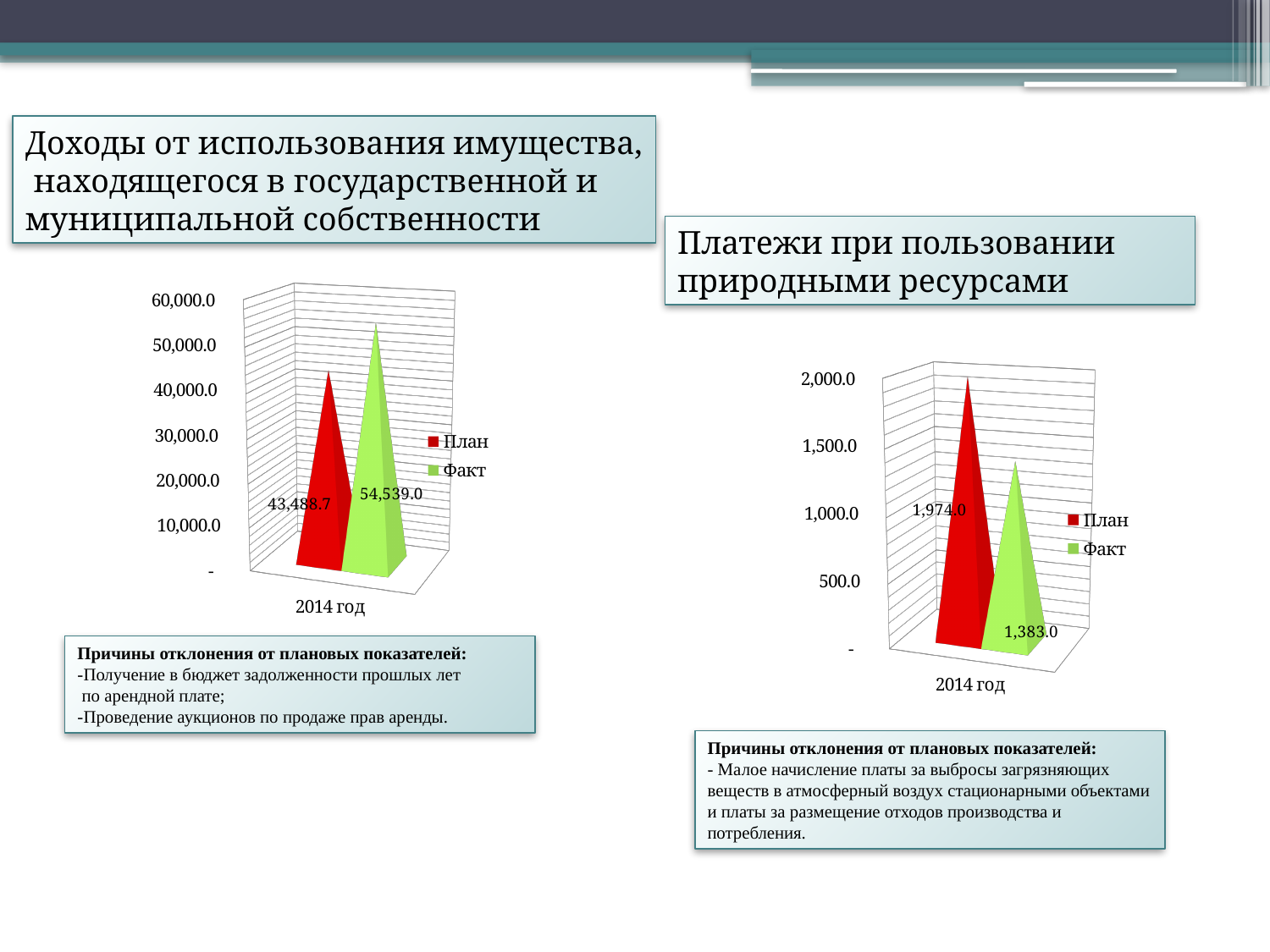
What kind of chart is the right chart (Платежи при пользовании природными ресурсами)? bar chart On the right chart (Платежи при пользовании природными ресурсами), is the value for Факт greater or less than 1,500.0? less On the left chart (Доходы от использования имущества), what is the value for Факт in 2014 год? 54,539.0 On the left chart (Доходы от использования имущества), what is the value for План in 2014 год? 43,488.7 How many series does the legend of the left chart (Доходы от использования имущества) list? 2 On the left chart (Доходы от использования имущества), is the value for План greater or less than 40,000.0? greater On the right chart (Платежи при пользовании природными ресурсами), which series is lower, План or Факт? Факт On the right chart (Платежи при пользовании природными ресурсами), what is the value for Факт? 1,383.0 On the right chart (Платежи при пользовании природными ресурсами), what is the value for План? 1,974.0 On the left chart (Доходы от использования имущества), which series is higher, План or Факт? Факт On the left chart (Доходы от использования имущества), what is the difference between Факт and План? 11,050.3 On the right chart (Платежи при пользовании природными ресурсами), what is the difference between План and Факт? 591.0